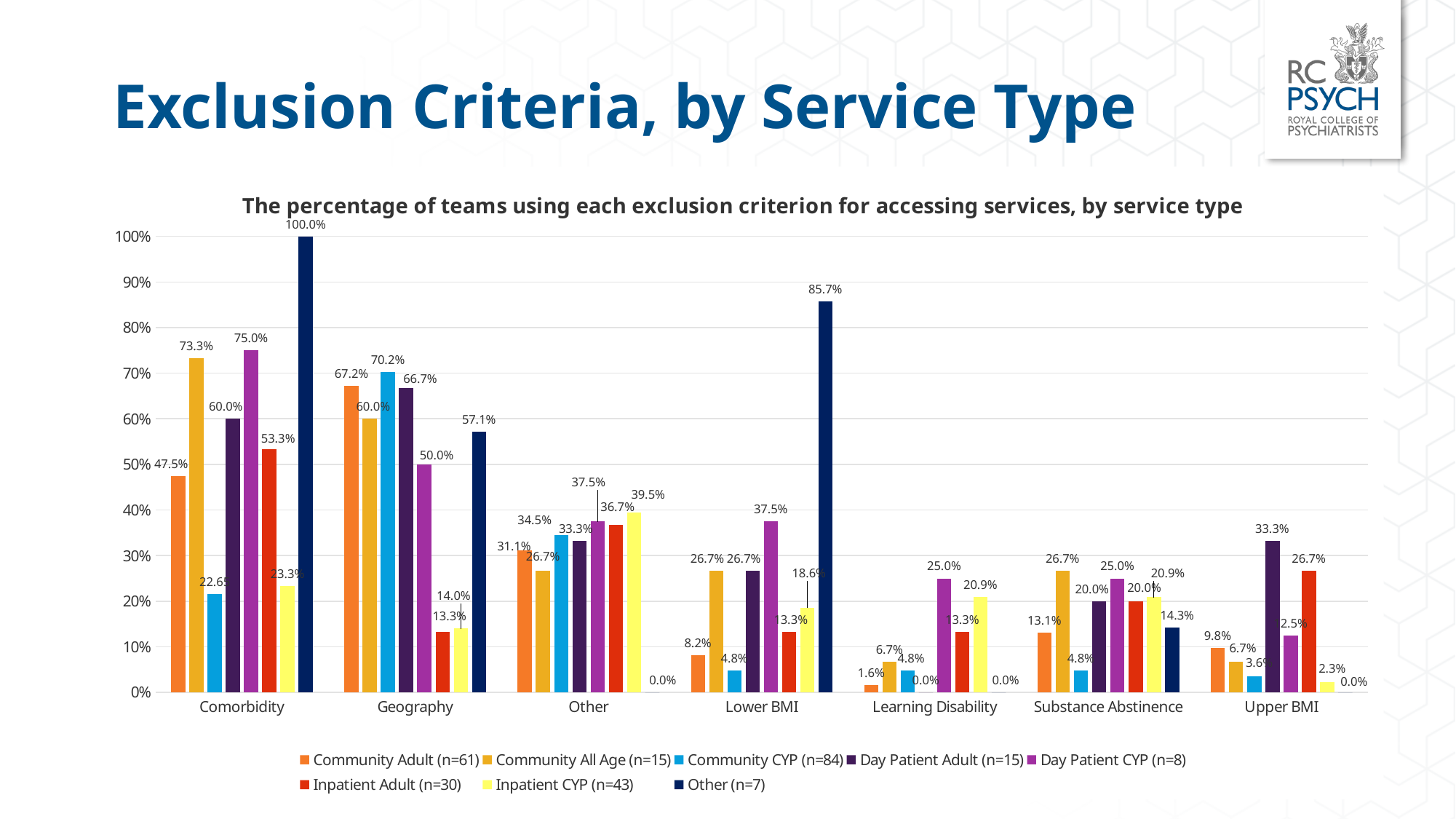
What kind of chart is shown on the slide? Bar chart What is the value for Community CYP (n=84) under Geography? 70.2% How many service types does the legend list? 8 What is the value for Other (n=7) under Lower BMI? 85.7% Under Substance Abstinence, which is larger: Community All Age (n=15) or Community Adult (n=61)? Community All Age (n=15) What is the title of the chart? The percentage of teams using each exclusion criterion for accessing services, by service type What is the value for Day Patient Adult (n=15) under Upper BMI? 33.3% How many exclusion criteria categories are shown on the x axis? 7 What percentage of Other (n=7) teams use Comorbidity as an exclusion criterion? 100.0% Which service type has the highest value for Geography? Community CYP (n=84) Which service type has the lowest value for Learning Disability? Day Patient Adult (n=15) and Other (n=7), both 0.0% What is the difference between the Community All Age (n=15) and Community Adult (n=61) values for Comorbidity? 25.8%